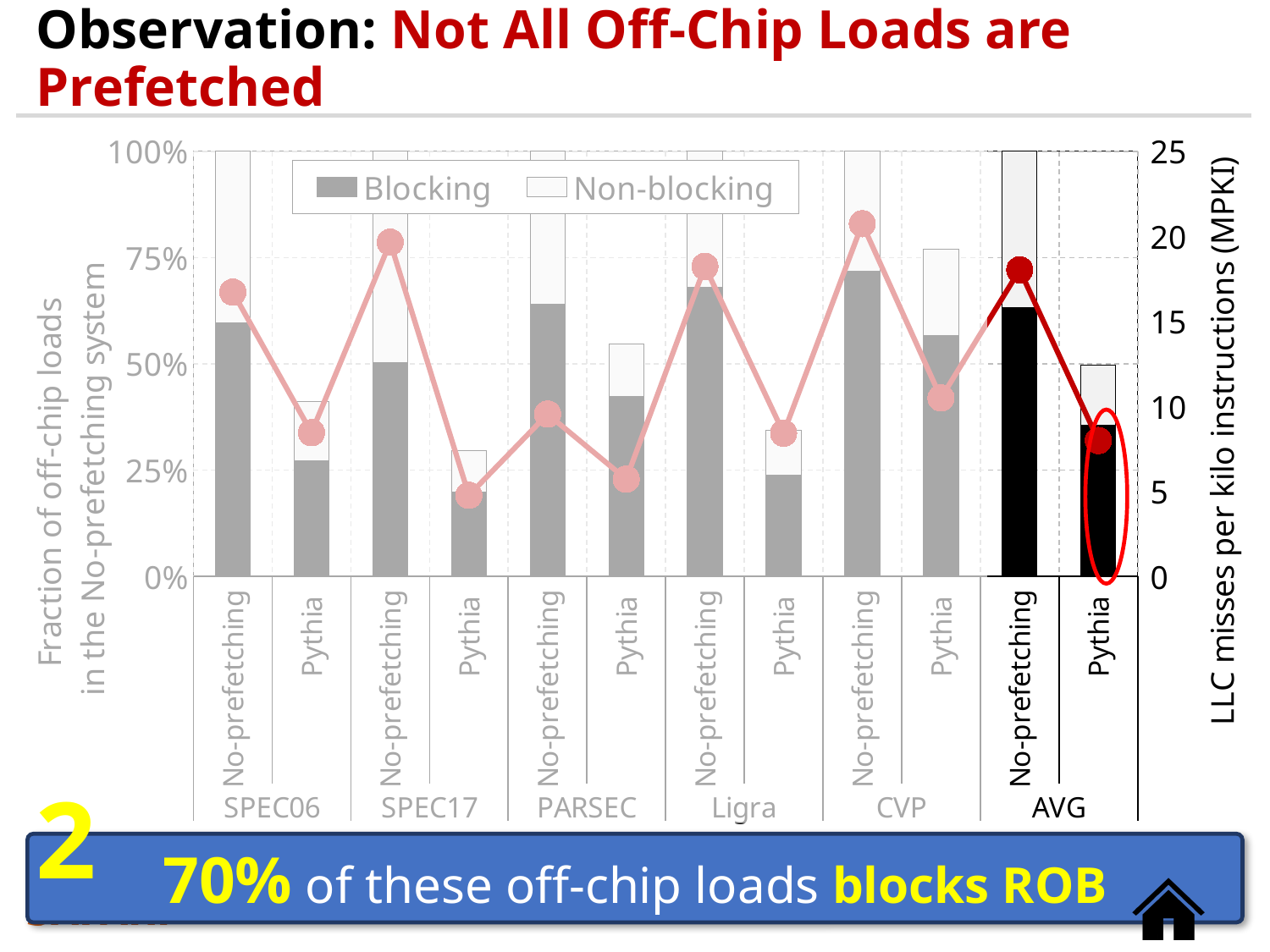
How many stacked bars are plotted in total? 12 How many benchmark groups are shown along the x axis? 6 Is the Blocking fraction for Pythia in AVG greater or less than 50%? less Is the LLC MPKI value for Pythia in PARSEC greater or less than 10? less Is the LLC MPKI value for No-prefetching in AVG greater or less than 15? greater In CVP, which has the higher LLC MPKI value: No-prefetching or Pythia? No-prefetching What is the label of the right-hand y axis? LLC misses per kilo instructions (MPKI) Which two series are listed in the legend? Blocking and Non-blocking What kind of chart is shown on the slide? Stacked bar chart with a line overlay How many series does the legend list? 2